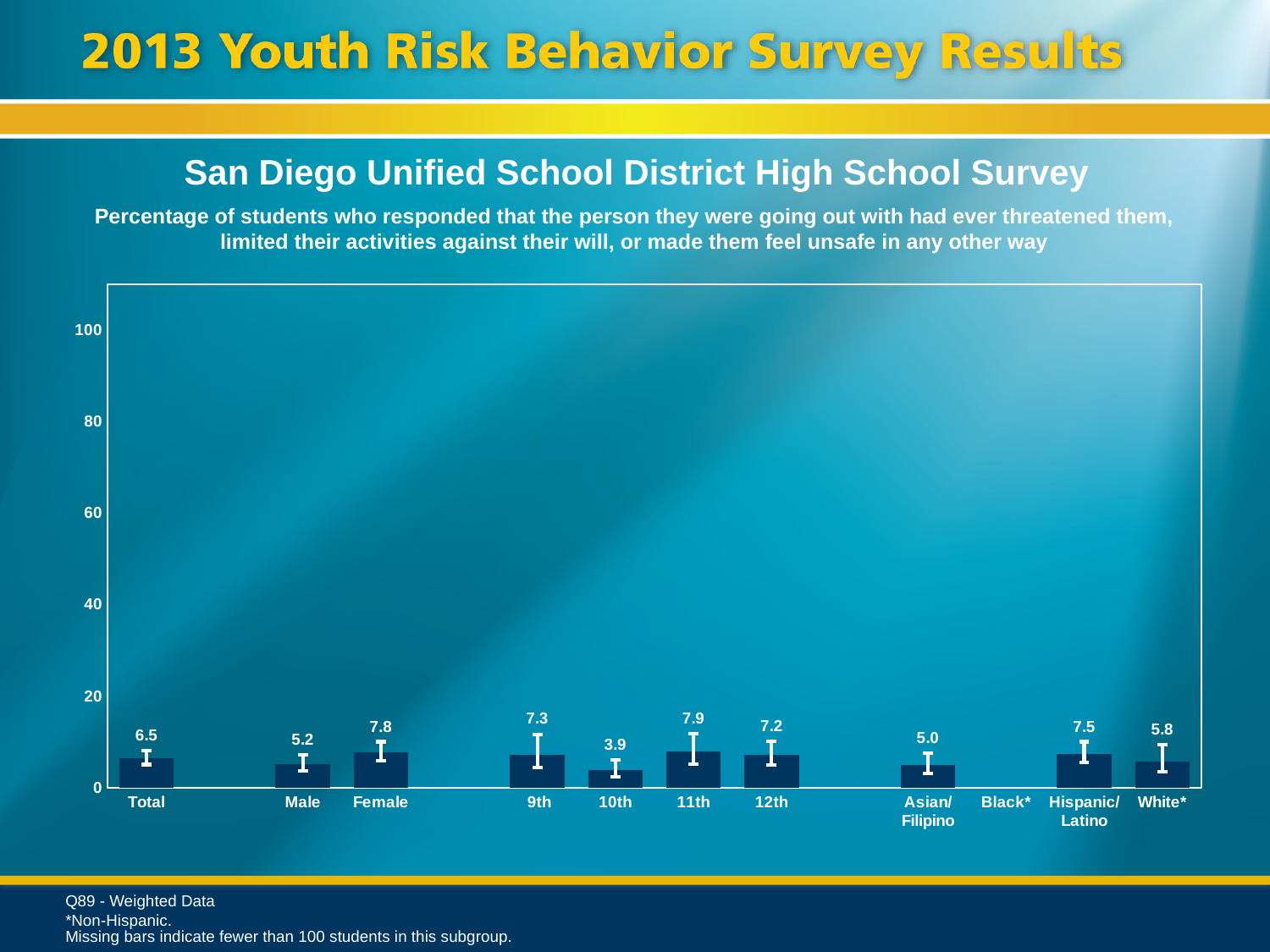
Which category has the highest value? 11th Which category with a plotted bar has the lowest value? 10th Is the value for Hispanic/Latino greater or less than 20? less What is the value for Asian/Filipino? 5.0 What is the value for Total? 6.5 What kind of chart is shown? bar chart What is the difference between the Female and Male values? 2.6 What is the value for 10th grade? 3.9 How many categories are labeled on the x axis? 11 Which is larger, the value for 9th grade or the value for 12th grade? 9th Which category has no bar plotted? Black* What is the value for Female? 7.8